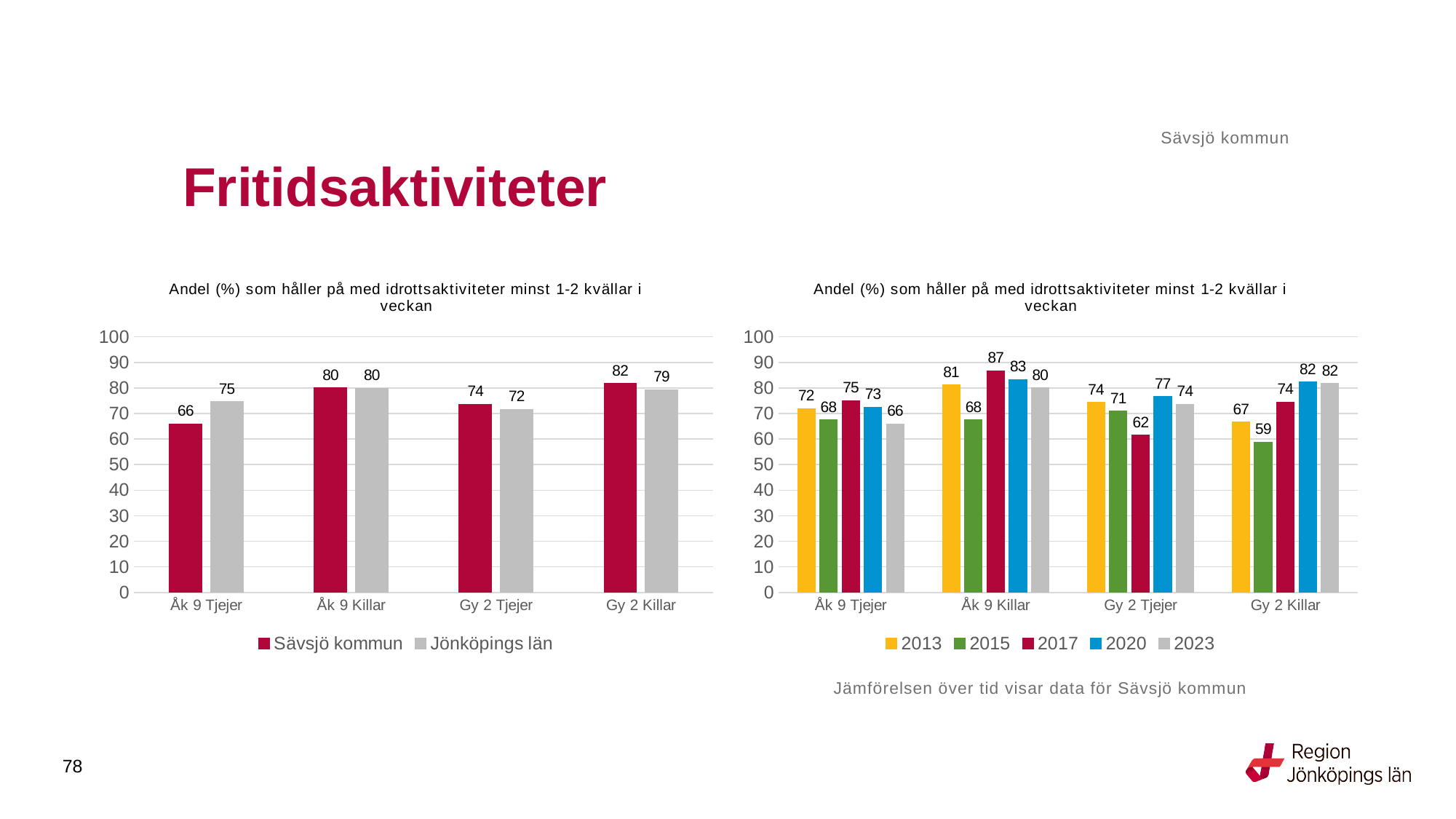
In the right chart, which year has the lowest value for Gy 2 Tjejer? 2017 In the left chart, how many series does the legend list? 2 In the left chart, what is the value for Sävsjö kommun for Åk 9 Tjejer? 66 In the left chart, what is the value for Jönköpings län for Gy 2 Killar? 79 In the right chart, what is the value for 2017 for Åk 9 Killar? 87 In the left chart, which category has the highest value for Sävsjö kommun? Gy 2 Killar In the right chart, how many categories are shown on the x axis? 4 What type of chart is the left chart? bar chart In the left chart, what is the difference between Jönköpings län and Sävsjö kommun for Åk 9 Tjejer? 9 In the right chart, what is the value for 2015 for Gy 2 Killar? 59 In the right chart, is the value for 2020 for Gy 2 Tjejer larger or smaller than the value for 2013 for Gy 2 Tjejer? larger In the right chart, how many series does the legend list? 5